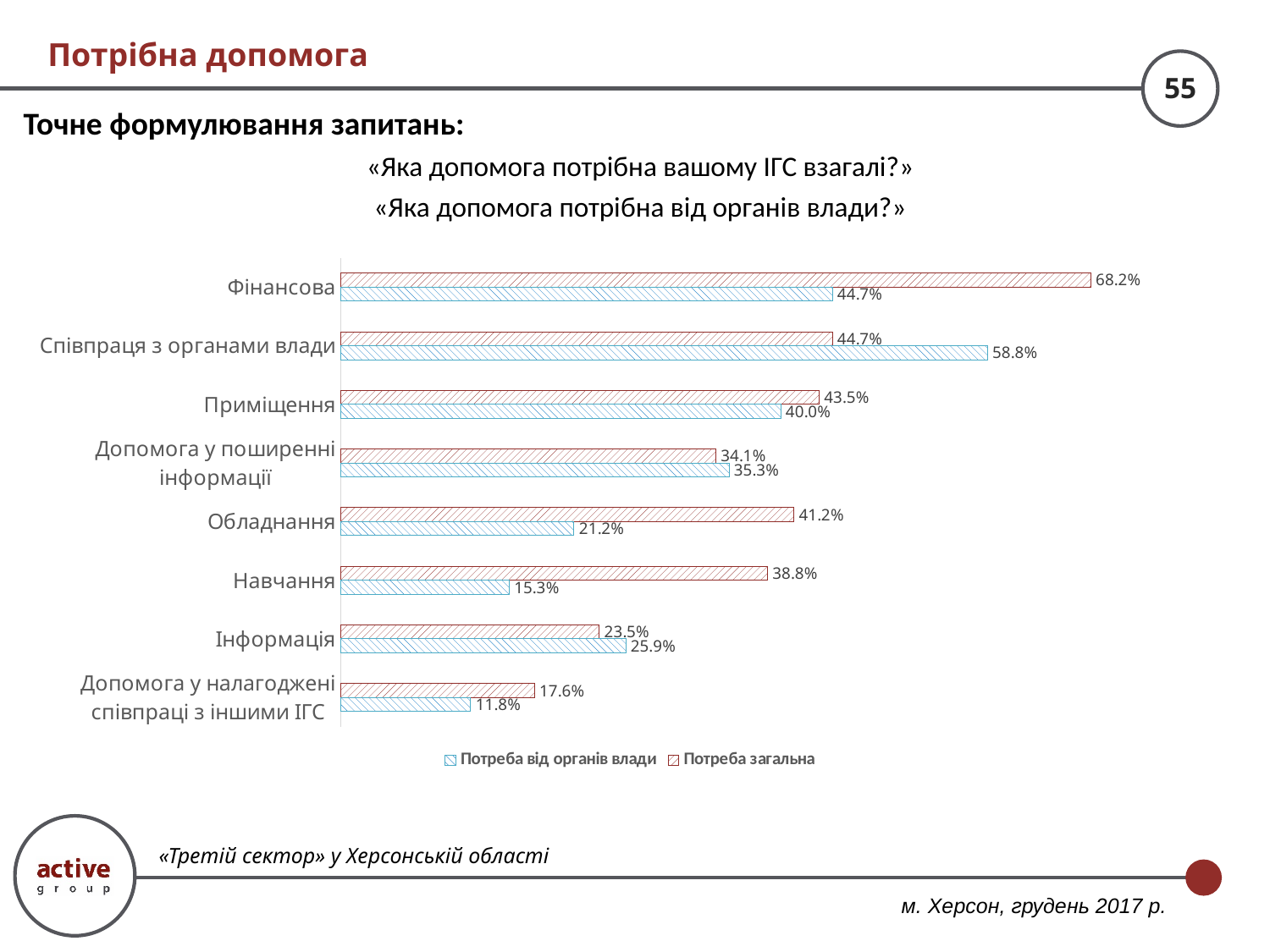
Which series is shown with blue hatched bars in the legend? Потреба від органів влади What is the difference between "Потреба загальна" and "Потреба від органів влади" for "Обладнання"? 20.0% What type of chart is shown on the slide? bar chart What is the value of "Потреба від органів влади" for "Навчання"? 15.3% What is the value of "Потреба загальна" for "Фінансова"? 68.2% How many categories are shown in the chart? 8 What is the value of "Потреба від органів влади" for "Співпраця з органами влади"? 58.8% Which category has the highest value for "Потреба загальна"? Фінансова Which category has the lowest value for "Потреба від органів влади"? Допомога у налагоджені співпраці з іншими ІГС What is the difference between "Потреба загальна" and "Потреба від органів влади" for "Фінансова"? 23.5% For "Інформація", which is larger: "Потреба від органів влади" or "Потреба загальна"? Потреба від органів влади How many series does the legend list? 2